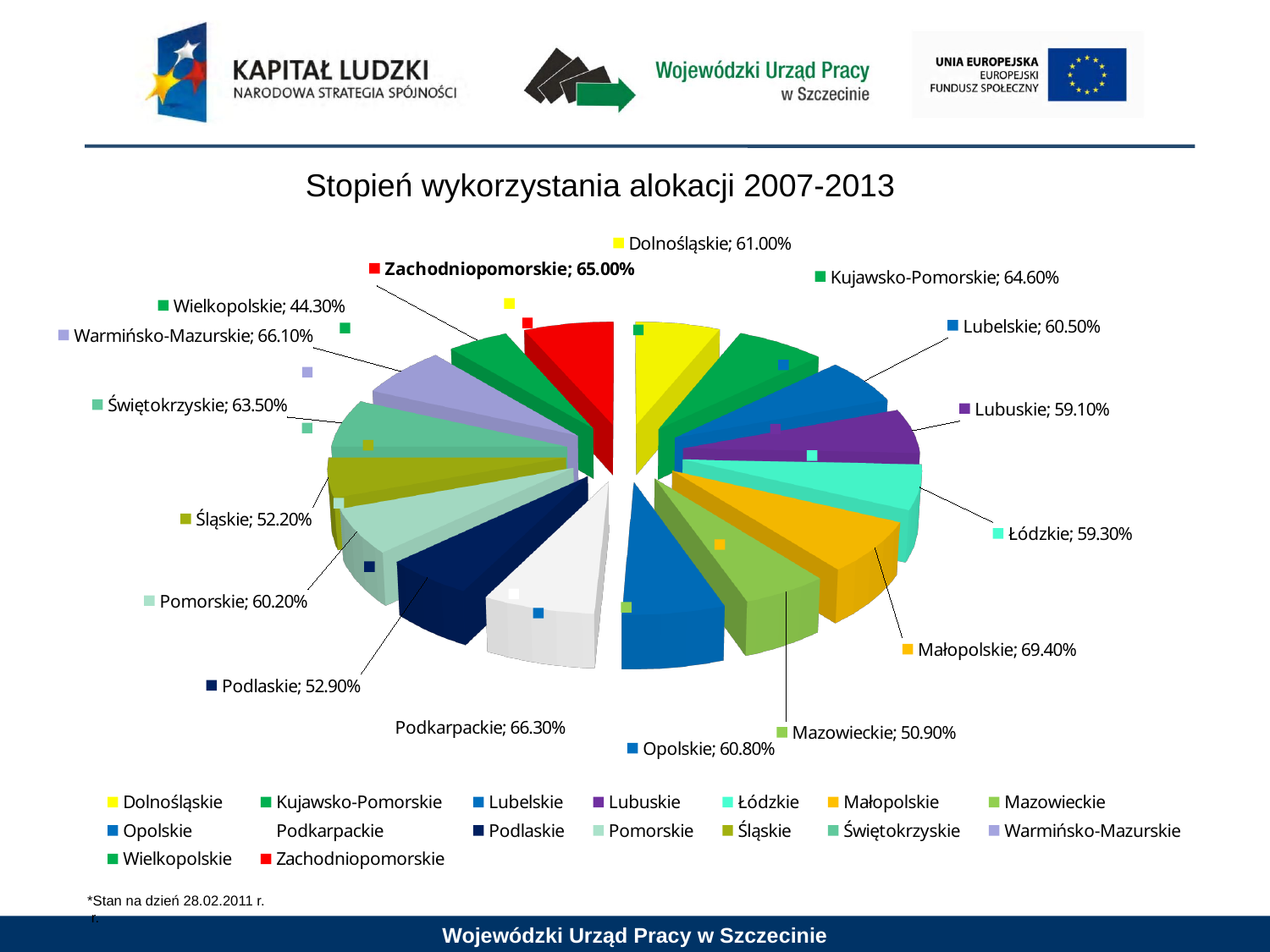
Which has a larger value, Podkarpackie or Warmińsko-Mazurskie? Podkarpackie What is the title of the chart? Stopień wykorzystania alokacji 2007-2013 How many regions are shown on the chart? 16 What is the difference between the values for Zachodniopomorskie and Podlaskie? 12.10% What is the difference between the values for Małopolskie and Wielkopolskie? 25.10% What is the value shown for Mazowieckie? 50.90% What kind of chart is shown on the slide? Pie chart What is the value shown for Wielkopolskie? 44.30% Which region has the highest value on the chart? Małopolskie Which region has the lowest value on the chart? Wielkopolskie What is the value shown for Małopolskie? 69.40% What is the value shown for Zachodniopomorskie? 65.00%